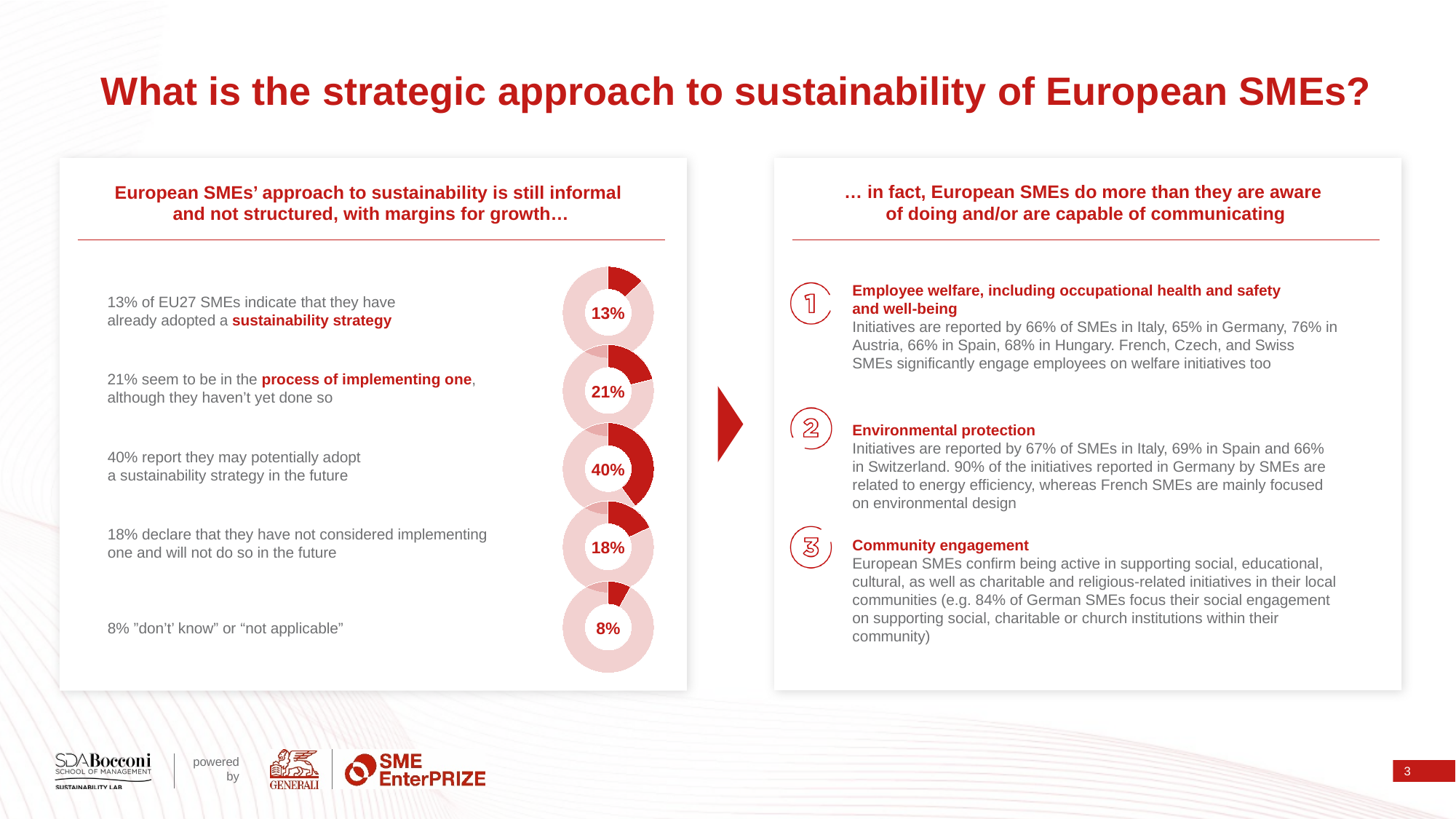
What percentage of SMEs report they may potentially adopt a sustainability strategy in the future, per the third donut chart? 40% What type of chart is used to display the percentages on the left panel? Donut (pie) chart Which of the five donut charts shows the highest percentage? 40% (may potentially adopt a sustainability strategy in the future) Which of the five donut charts shows the lowest percentage? 8% ("don't know" or "not applicable") How many donut charts are shown on the left panel of the slide? 5 What value does the second donut chart show for SMEs in the process of implementing a sustainability strategy? 21% What percentage is shown in the bottom donut chart for "don't know" or "not applicable"? 8% What is the difference between the share of SMEs that may potentially adopt a strategy in the future (40%) and the share that have already adopted one (13%)? 27% What percentage of EU27 SMEs indicate they have already adopted a sustainability strategy, according to the first donut chart? 13% What value is shown in the donut chart for SMEs that have not considered implementing a sustainability strategy and will not do so? 18% What is the total of the five percentages shown in the donut charts? 100% Which is larger: the share of SMEs in the process of implementing a sustainability strategy or the share that have not considered implementing one? In the process of implementing one (21%)